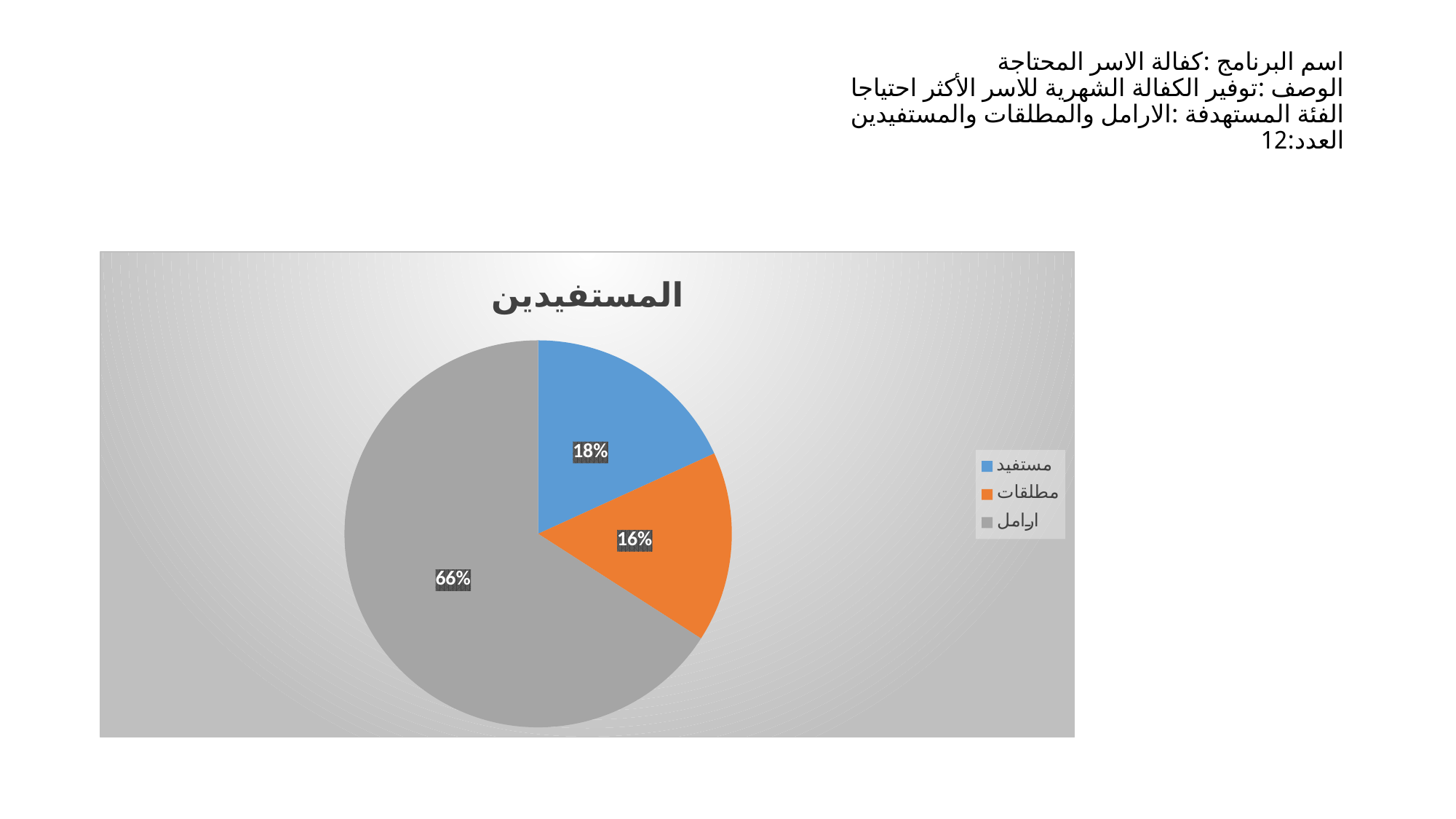
What percentage of the pie does the مطلقات slice represent? 16% Which category has the largest share of the pie? ارامل What percentage of the pie does the مستفيد slice represent? 18% What is the difference in percentage points between the ارامل slice and the مستفيد slice? 48 What is the difference in percentage points between the مستفيد slice and the مطلقات slice? 2 Which category has the smallest share of the pie? مطلقات What percentage of the pie does the ارامل slice represent? 66% What is the title of the chart? المستفيدين How many slices does the pie chart have? 3 Which is larger, the share for مستفيد or the share for مطلقات? مستفيد What kind of chart is shown on the slide? pie chart Which colour represents ارامل in the legend? gray